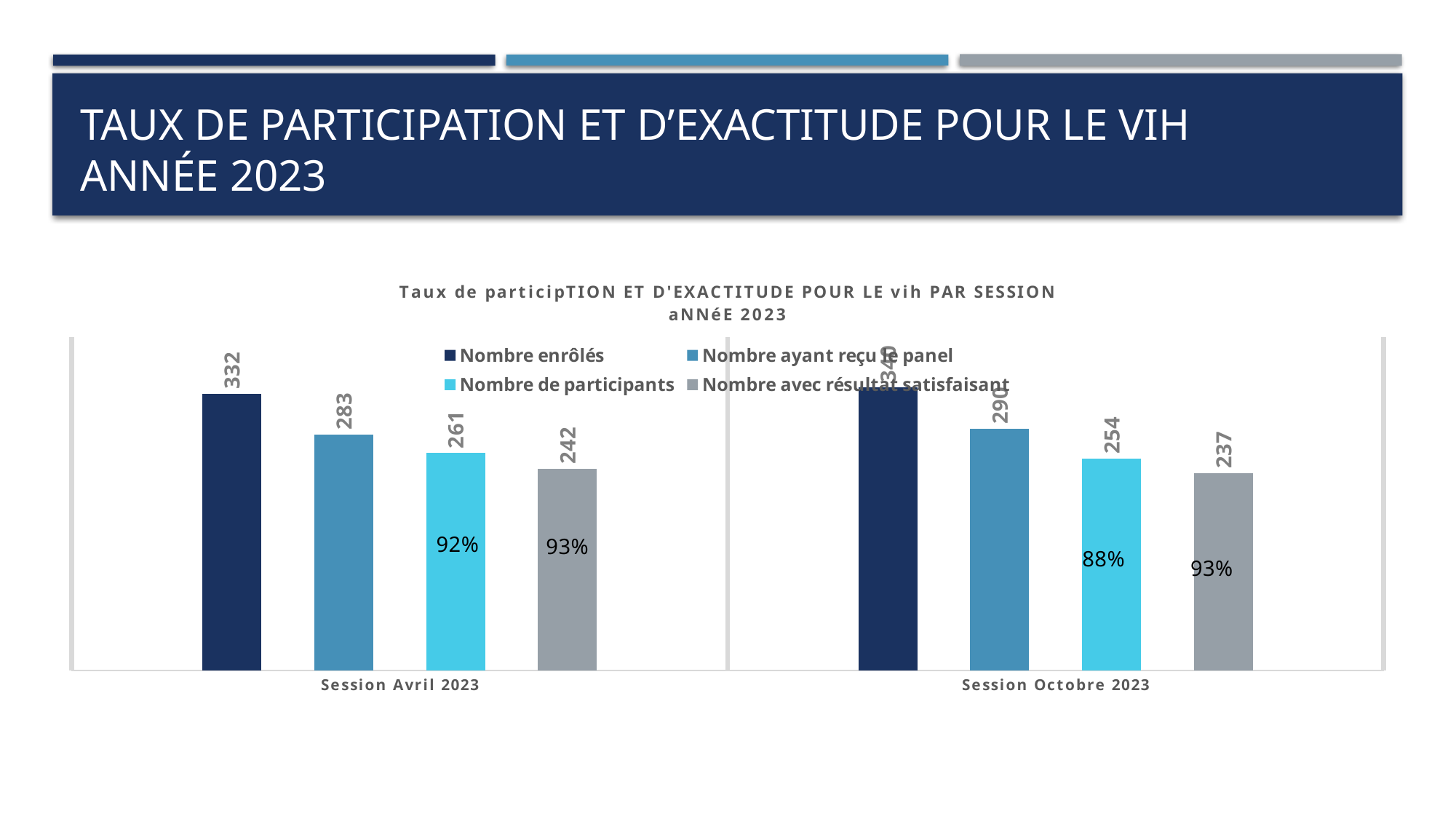
How many series does the legend list? 4 What is the value of Nombre de participants for Session Avril 2023? 261 What kind of chart is shown on the slide? Bar chart Which session has the higher Nombre de participants, Session Avril 2023 or Session Octobre 2023? Session Avril 2023 What is the value of Nombre avec résultat satisfaisant for Session Octobre 2023? 237 What percentage is printed on the Nombre de participants bar for Session Octobre 2023? 88% Which series has the lowest value for Session Avril 2023? Nombre avec résultat satisfaisant What is the difference between Nombre de participants and Nombre avec résultat satisfaisant for Session Octobre 2023? 17 What is the value of Nombre enrôlés for Session Avril 2023? 332 How many sessions (categories) are shown on the x axis? 2 What is the difference between Nombre enrôlés and Nombre ayant reçu le panel for Session Avril 2023? 49 What is the value of Nombre ayant reçu le panel for Session Octobre 2023? 290